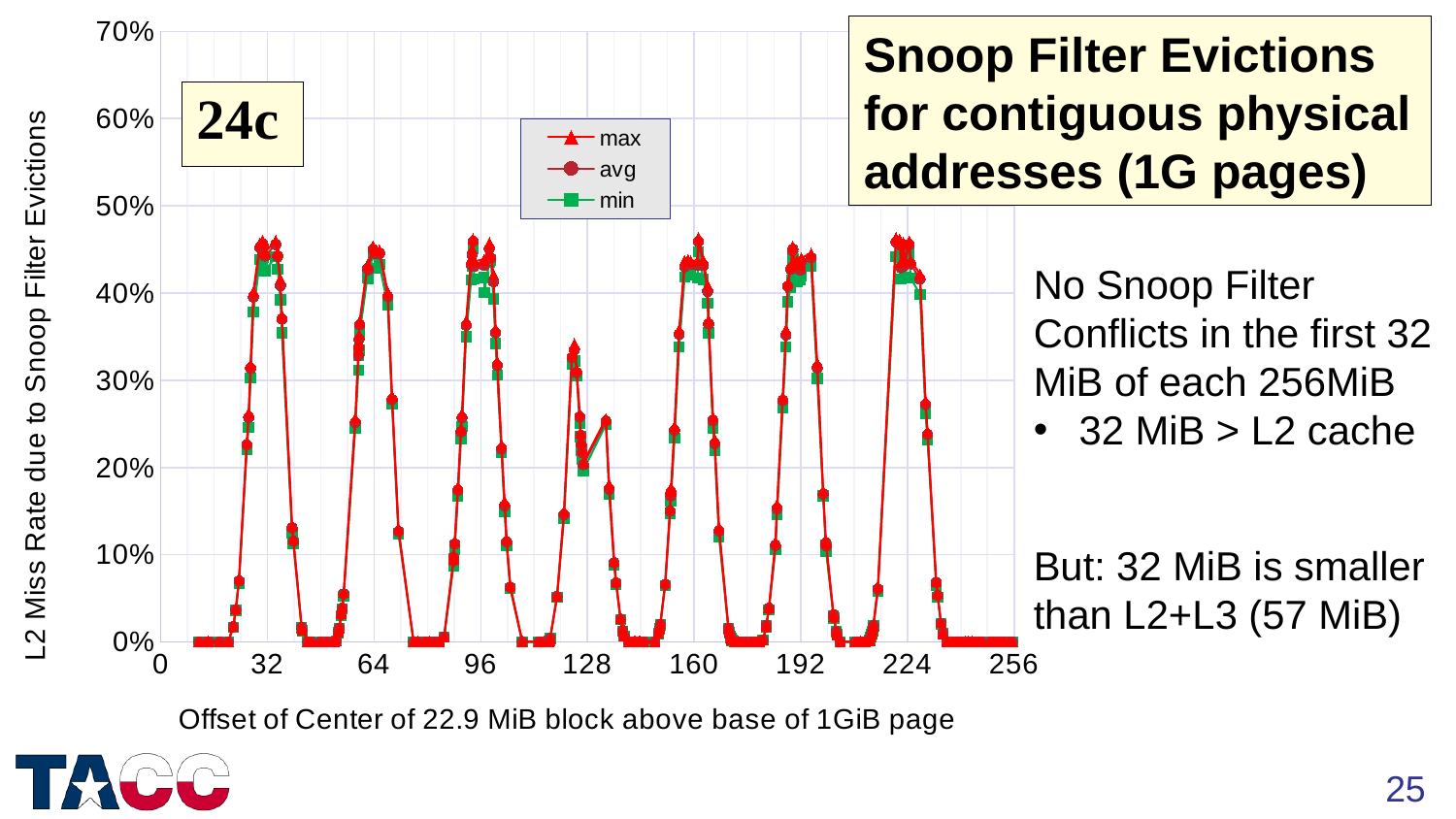
How many series does the chart legend list? 3 What is the title of the chart's y axis? L2 Miss Rate due to Snoop Filter Evictions Which peak is lower: the one near offset 32 or the one near offset 128? the one near offset 128 How many peaks does the miss-rate curve show between offsets 0 and 256? 7 Is the peak value of the max series near offset 128 greater or less than 40%? less Is the peak value of the max series near offset 32 greater or less than 40%? greater What is the highest value shown on the chart's y axis? 70% Around which x-axis offset does the lowest of the peaks occur? 128 What kind of chart is shown on the slide? line chart What are the three series named in the chart legend? max, avg, min Is the value of the min series at offset 16 greater or less than 10%? less What is the largest tick value shown on the chart's x axis? 256